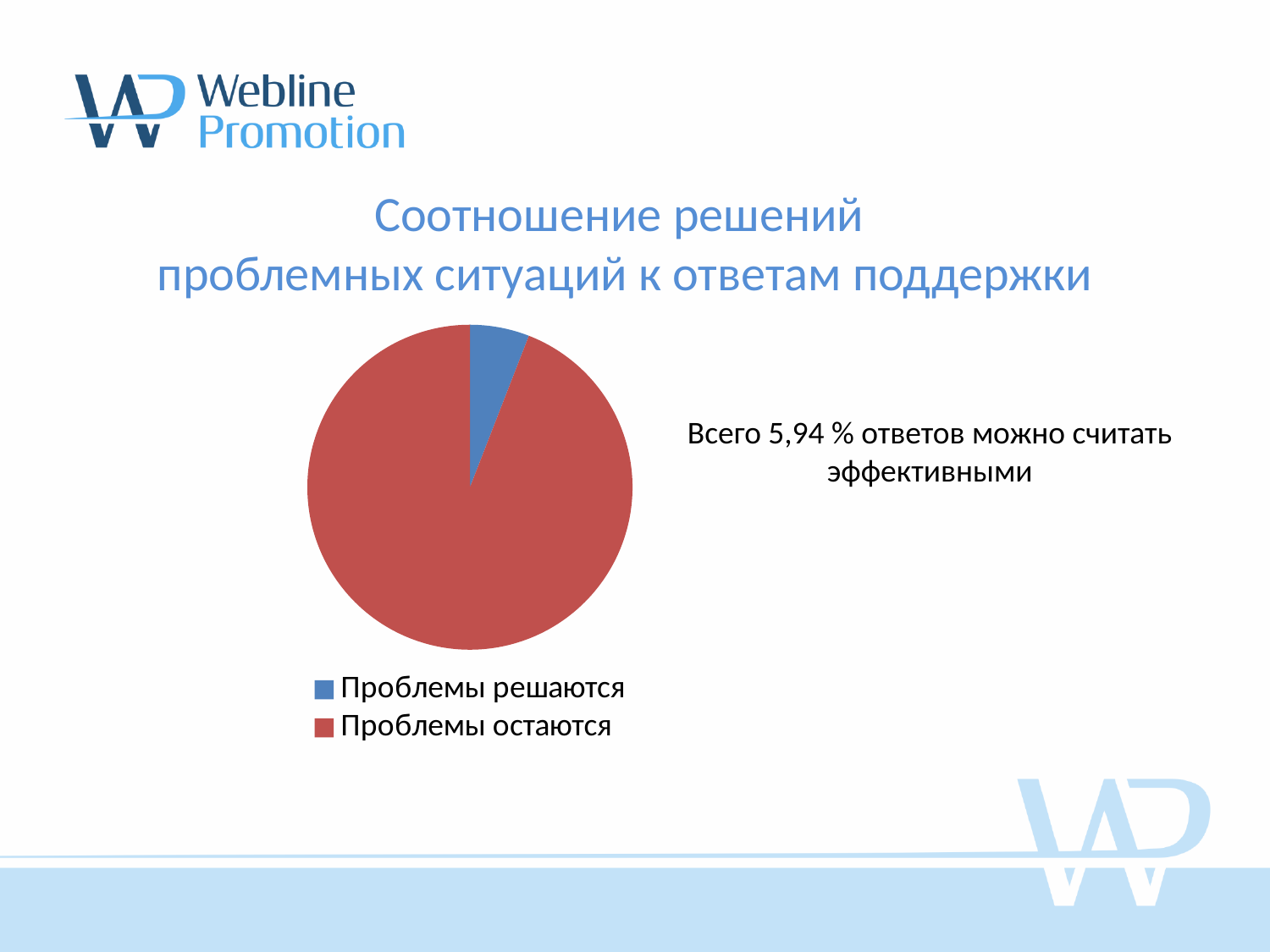
Which slice is larger: Проблемы решаются or Проблемы остаются? Проблемы остаются Which category has the smallest slice in the pie chart? Проблемы решаются How many slices does the pie chart have? 2 Which category has the largest slice in the pie chart? Проблемы остаются According to the text next to the chart, what percentage of answers can be considered effective? 5,94 % What kind of chart is shown on the slide? pie chart What is the title of the chart on the slide? Соотношение решений проблемных ситуаций к ответам поддержки How many entries does the legend of the pie chart list? 2